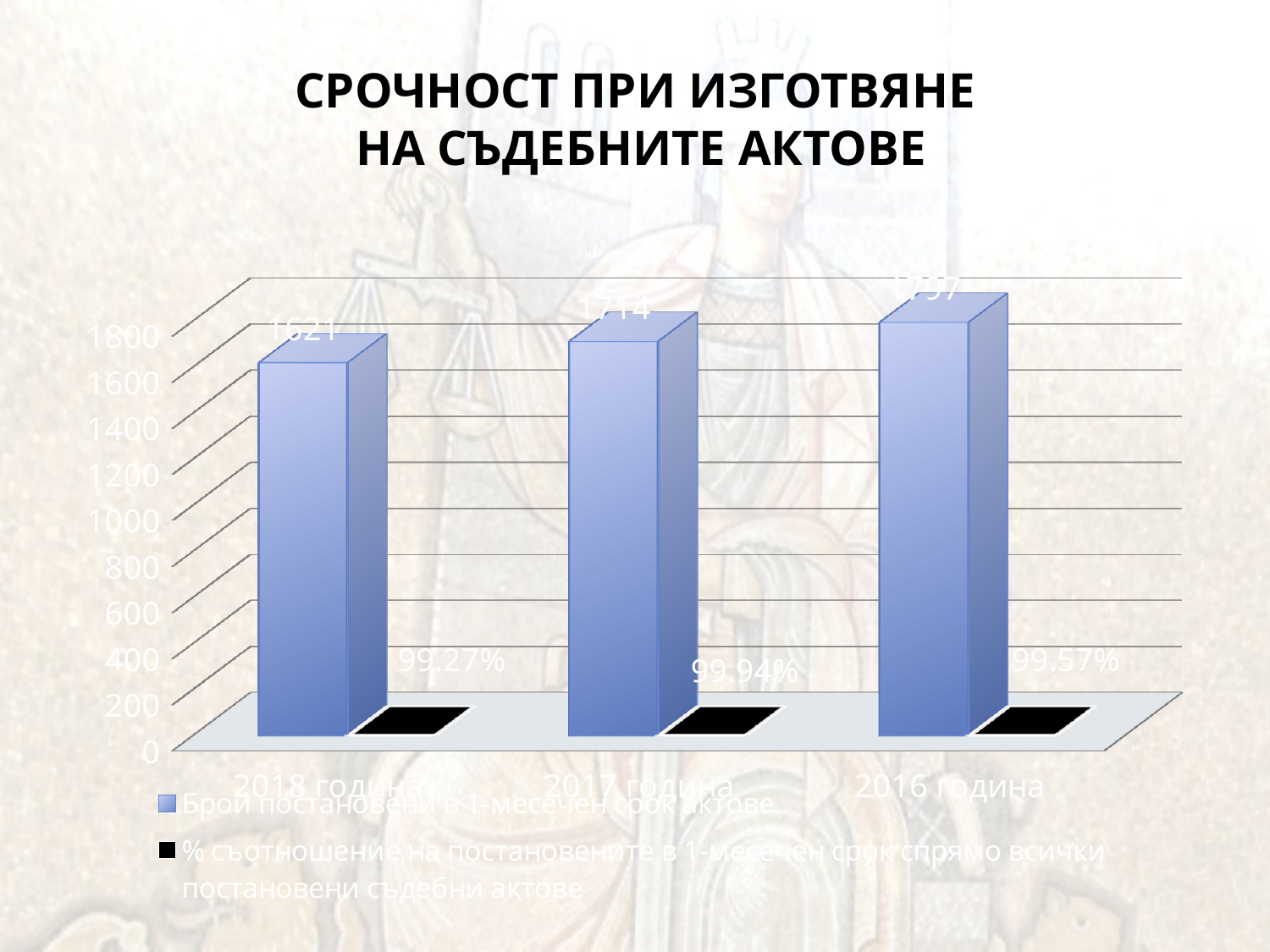
Which year has the highest percentage of acts issued within the 1-month period? 2017 година What is the value of 'Брой постановени в 1-месечен срок актове' for 2017 година? 1714 Which year has the lowest percentage of acts issued within the 1-month period? 2018 година How many acts were issued within the 1-month period in 2018 година? 1621 What percentage is shown for 2016 година? 99.57% How many years are shown on the x axis of the chart? 3 Is the number of acts issued within the 1-month period for 2016 година greater or less than 1600? greater What is the difference between the number of acts issued within the 1-month period in 2017 година and 2018 година? 93 Which year has the taller blue bar, 2018 година or 2017 година? 2017 година How many series does the chart legend list? 2 What percentage is shown for 2018 година? 99.27% What percentage is shown for 2017 година? 99.94%